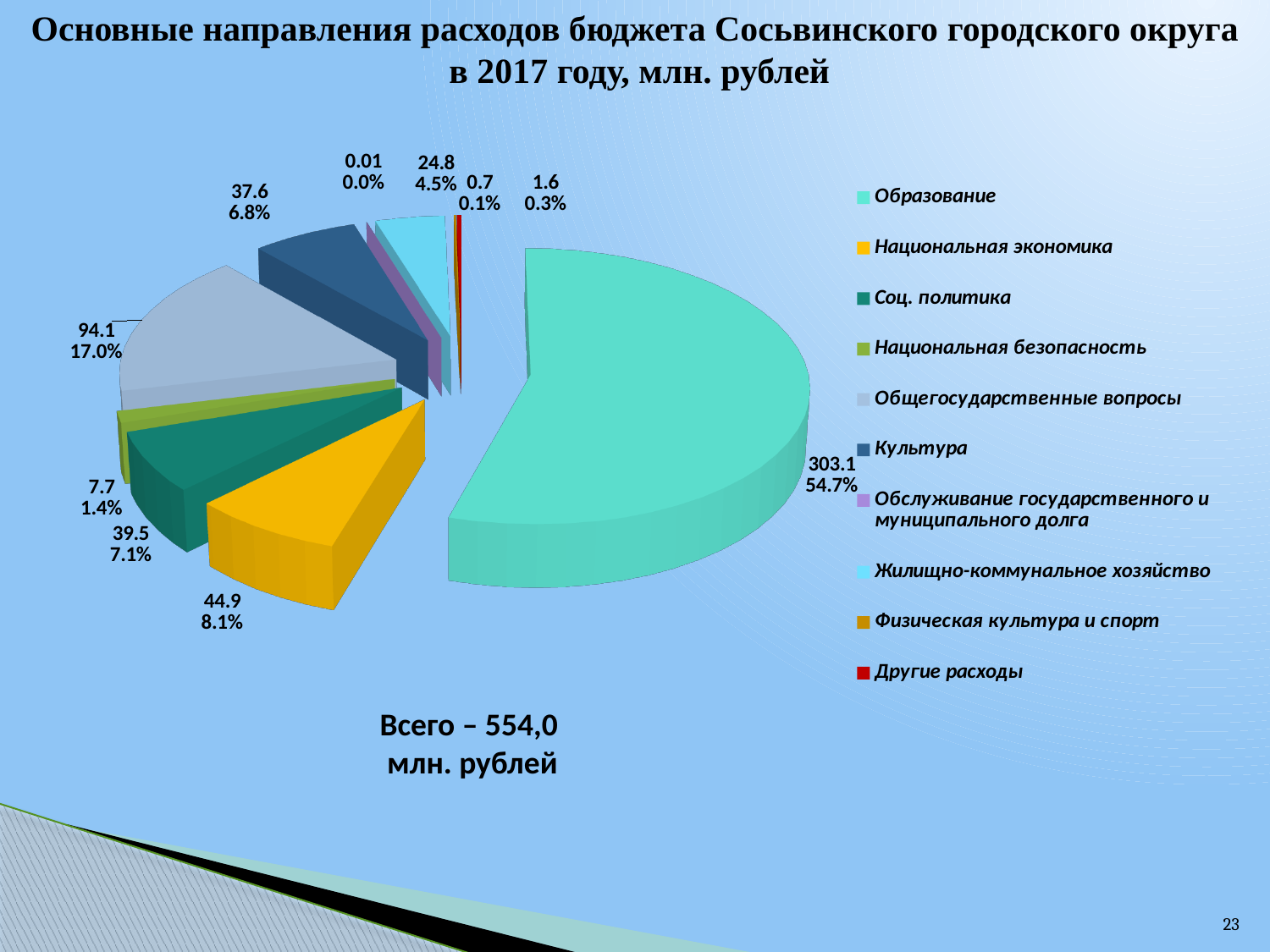
What value is shown for Общегосударственные вопросы? 94.1 What is the difference between the values for Национальная экономика and Соц. политика? 5.4 What total is stated on the slide for the budget expenditures? 554,0 млн. рублей What value is shown for Образование? 303.1 How many categories does the legend of the pie chart list? 10 Which category has the smallest slice of the pie? Обслуживание государственного и муниципального долга What share of the pie does Национальная экономика account for? 8.1% Which category has the largest slice of the pie? Образование What colour is the slice for Национальная экономика? yellow What kind of chart is shown on the slide? pie chart Which is larger, the value for Соц. политика or the value for Культура? Соц. политика What share of the pie does Образование account for? 54.7%